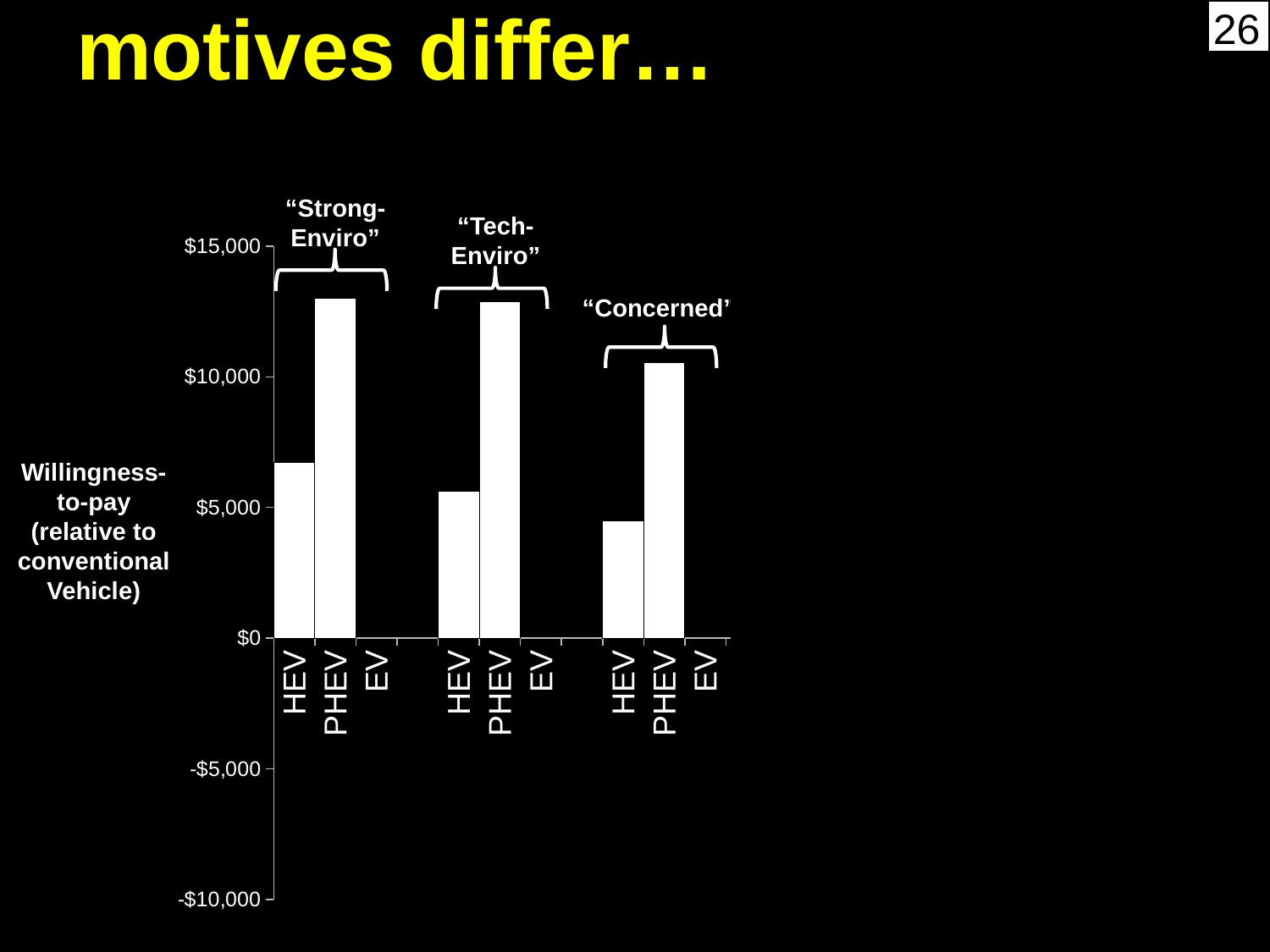
What is the label on the vertical axis of the chart? Willingness-to-pay (relative to conventional Vehicle) Is the PHEV value for the "Tech-Enviro" group greater or less than $10,000? greater Which is larger, the HEV value for "Strong-Enviro" or the HEV value for "Concerned"? Strong-Enviro Is the PHEV value for the "Strong-Enviro" group greater or less than $10,000? greater Which group has the lowest PHEV value? Concerned How many vehicle-type labels appear along the x axis in total? 9 Within the "Strong-Enviro" group, which is larger, the HEV value or the PHEV value? PHEV Which group has the highest HEV value? Strong-Enviro How many segment groups (bracketed labels) are shown above the bars? 3 Is the HEV value for the "Concerned" group greater or less than $5,000? less What kind of chart is shown on the slide? bar chart